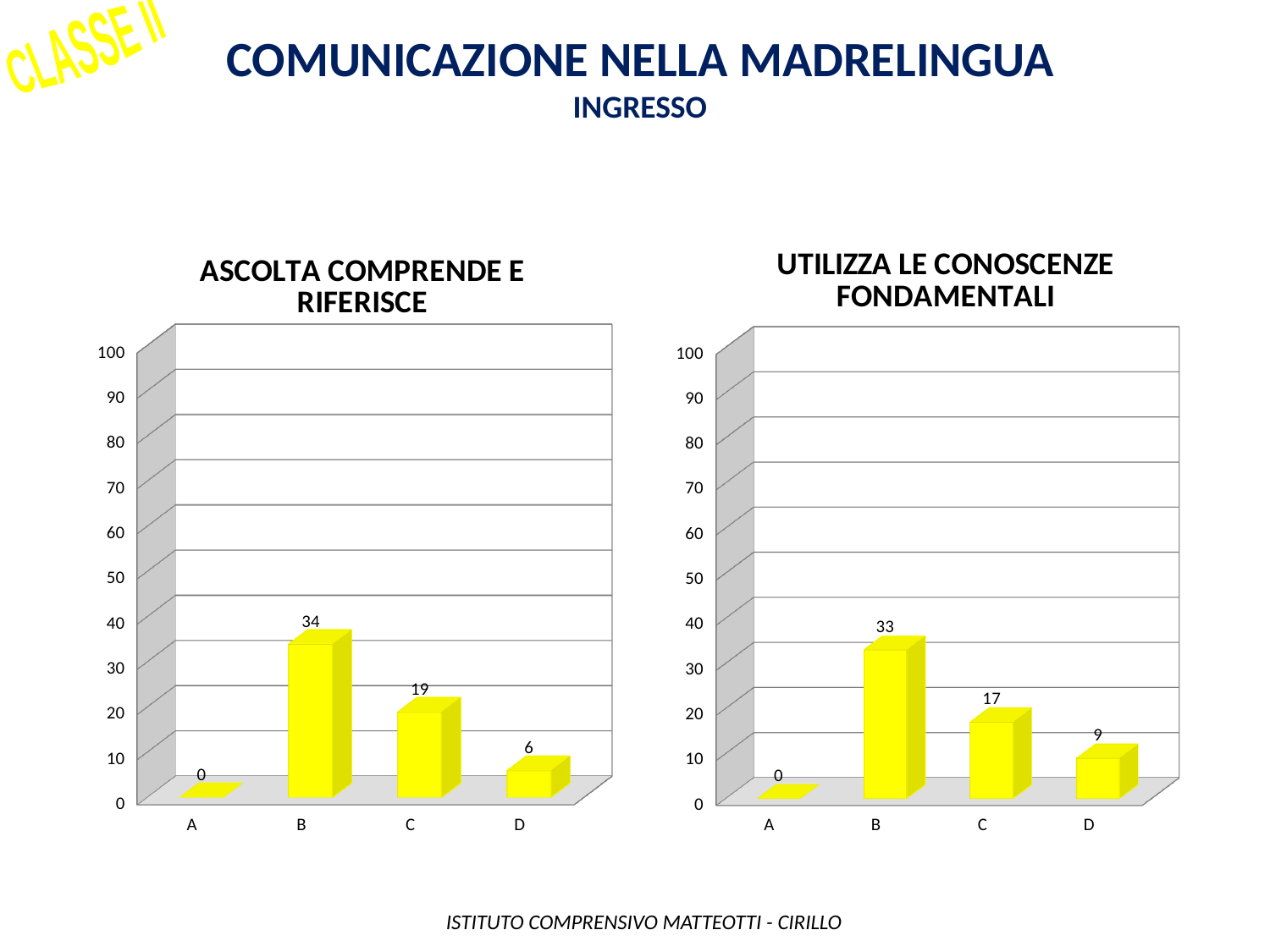
In the 'ASCOLTA COMPRENDE E RIFERISCE' chart, which category has the highest value? B What is the title of the chart on the right side of the slide? UTILIZZA LE CONOSCENZE FONDAMENTALI How many categories are shown on the x axis of the 'UTILIZZA LE CONOSCENZE FONDAMENTALI' chart? 4 In the 'UTILIZZA LE CONOSCENZE FONDAMENTALI' chart, what is the difference between the values for B and D? 24 In the 'UTILIZZA LE CONOSCENZE FONDAMENTALI' chart, what is the value for C? 17 What kind of chart is the 'ASCOLTA COMPRENDE E RIFERISCE' chart? Bar chart In the 'UTILIZZA LE CONOSCENZE FONDAMENTALI' chart, which category has the lowest value? A In the 'ASCOLTA COMPRENDE E RIFERISCE' chart, what is the difference between the values for B and C? 15 In the 'UTILIZZA LE CONOSCENZE FONDAMENTALI' chart, what is the value for A? 0 Which is larger: the value for C in the 'ASCOLTA COMPRENDE E RIFERISCE' chart or the value for C in the 'UTILIZZA LE CONOSCENZE FONDAMENTALI' chart? ASCOLTA COMPRENDE E RIFERISCE (19) In the 'ASCOLTA COMPRENDE E RIFERISCE' chart, what is the value for D? 6 In the 'ASCOLTA COMPRENDE E RIFERISCE' chart, what is the value for B? 34